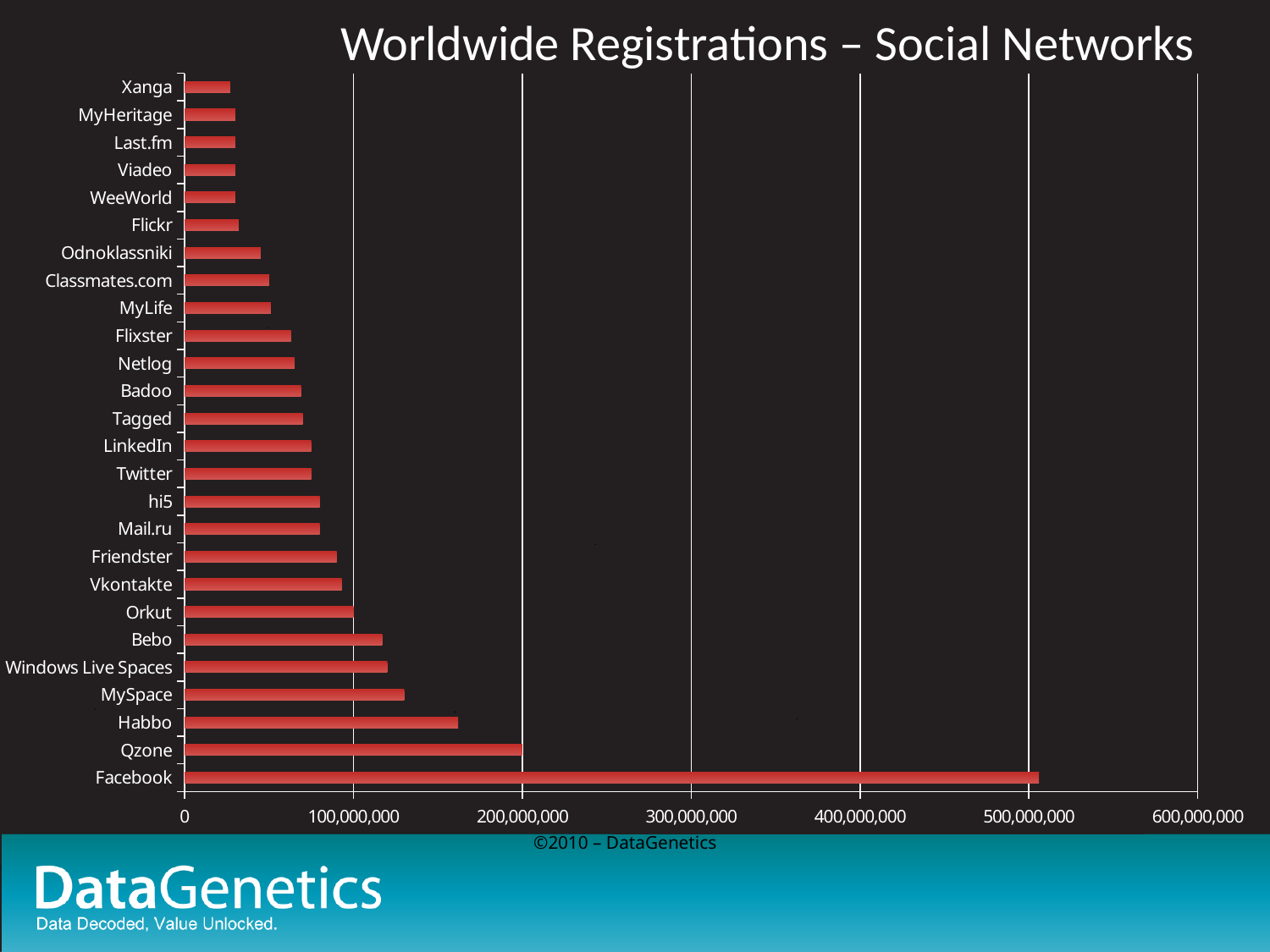
How many social networks are listed on the chart? 26 Is the value for Flickr greater or less than 100,000,000? less Is the value for Facebook greater or less than 500,000,000? greater What kind of chart is shown on the slide? bar chart Which social network has the lowest number of worldwide registrations? Xanga What is the title of the chart? Worldwide Registrations – Social Networks What colour are the bars on the chart? red Which social network has the highest number of worldwide registrations? Facebook Is the value for Twitter greater or less than 100,000,000? less What is the value for Qzone? 200,000,000 Which has more registrations, Habbo or MySpace? Habbo